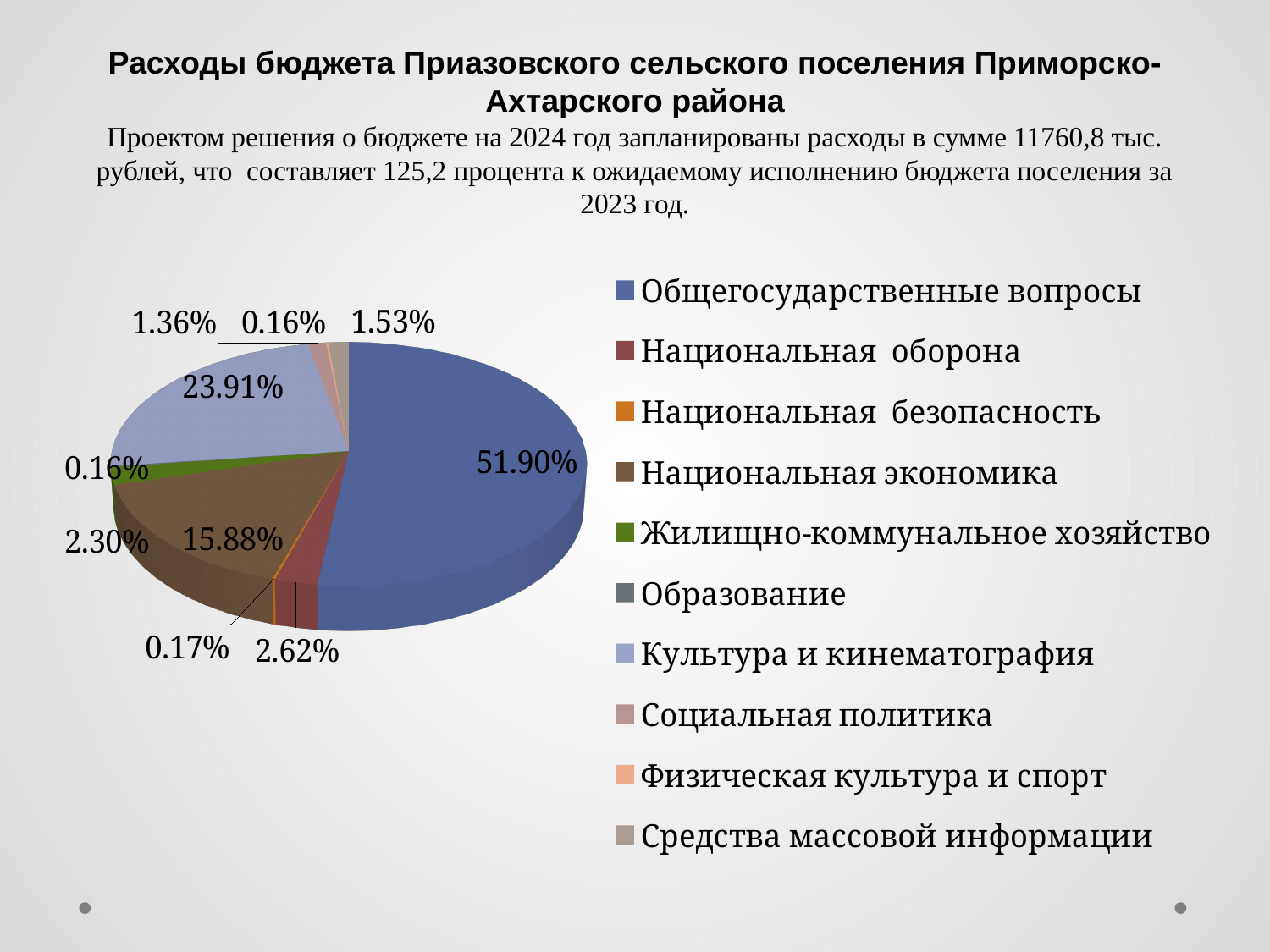
What share of the pie does Общегосударственные вопросы have? 51.90% What share of the pie does Национальная оборона have? 2.62% What share of the pie does Национальная экономика have? 15.88% Which has the larger share: Национальная экономика or Культура и кинематография? Культура и кинематография What colour is the slice for Общегосударственные вопросы? blue What kind of chart is shown on the slide? pie chart Which category has the largest share of the pie chart? Общегосударственные вопросы What is the difference between the shares of Общегосударственные вопросы and Культура и кинематография? 27.99% Which has the larger share: Национальная оборона or Национальная экономика? Национальная экономика How many categories does the legend of the pie chart list? 10 What is the difference between the shares of Культура и кинематография and Национальная экономика? 8.03%